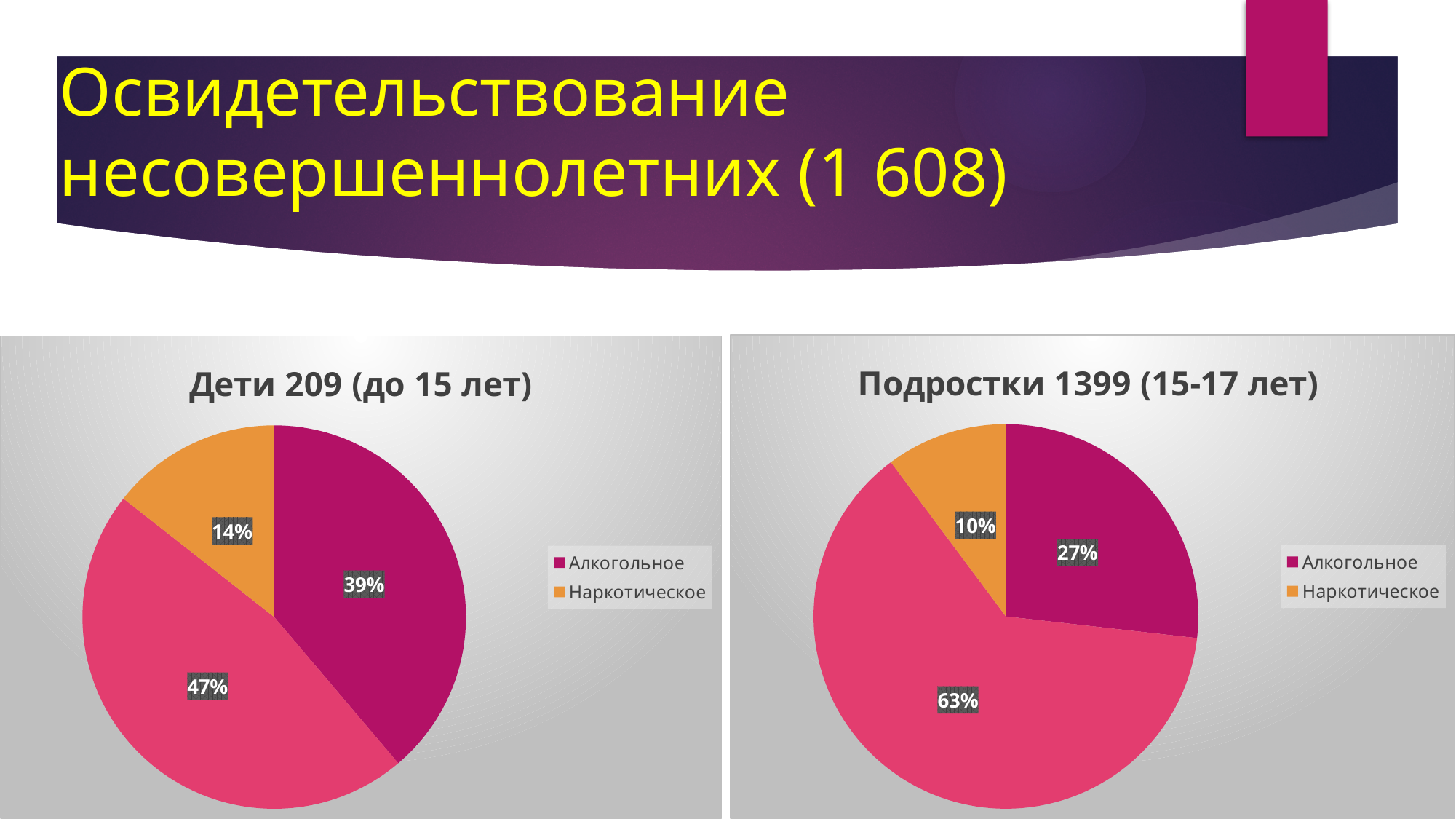
In the chart titled "Дети 209 (до 15 лет)", what percentage is shown for Алкогольное? 39% What is the title of the chart on the right side of the slide? Подростки 1399 (15-17 лет) In the chart titled "Дети 209 (до 15 лет)", which is larger: Алкогольное or Наркотическое? Алкогольное In the chart titled "Подростки 1399 (15-17 лет)", what percentage is shown for Наркотическое? 10% How many entries does the legend of the right chart list? 2 In the chart titled "Дети 209 (до 15 лет)", what is the difference in percentage points between Алкогольное and Наркотическое? 25 percentage points In the chart titled "Дети 209 (до 15 лет)", what percentage is shown for Наркотическое? 14% How many slices does the pie chart titled "Подростки 1399 (15-17 лет)" have? 3 In the chart titled "Подростки 1399 (15-17 лет)", what is the difference in percentage points between Алкогольное and Наркотическое? 17 percentage points What type of chart is used on the left side of the slide? Pie chart Which chart shows a larger share for Алкогольное: "Дети 209 (до 15 лет)" or "Подростки 1399 (15-17 лет)"? Дети 209 (до 15 лет) In the chart titled "Подростки 1399 (15-17 лет)", what percentage is shown for Алкогольное? 27%